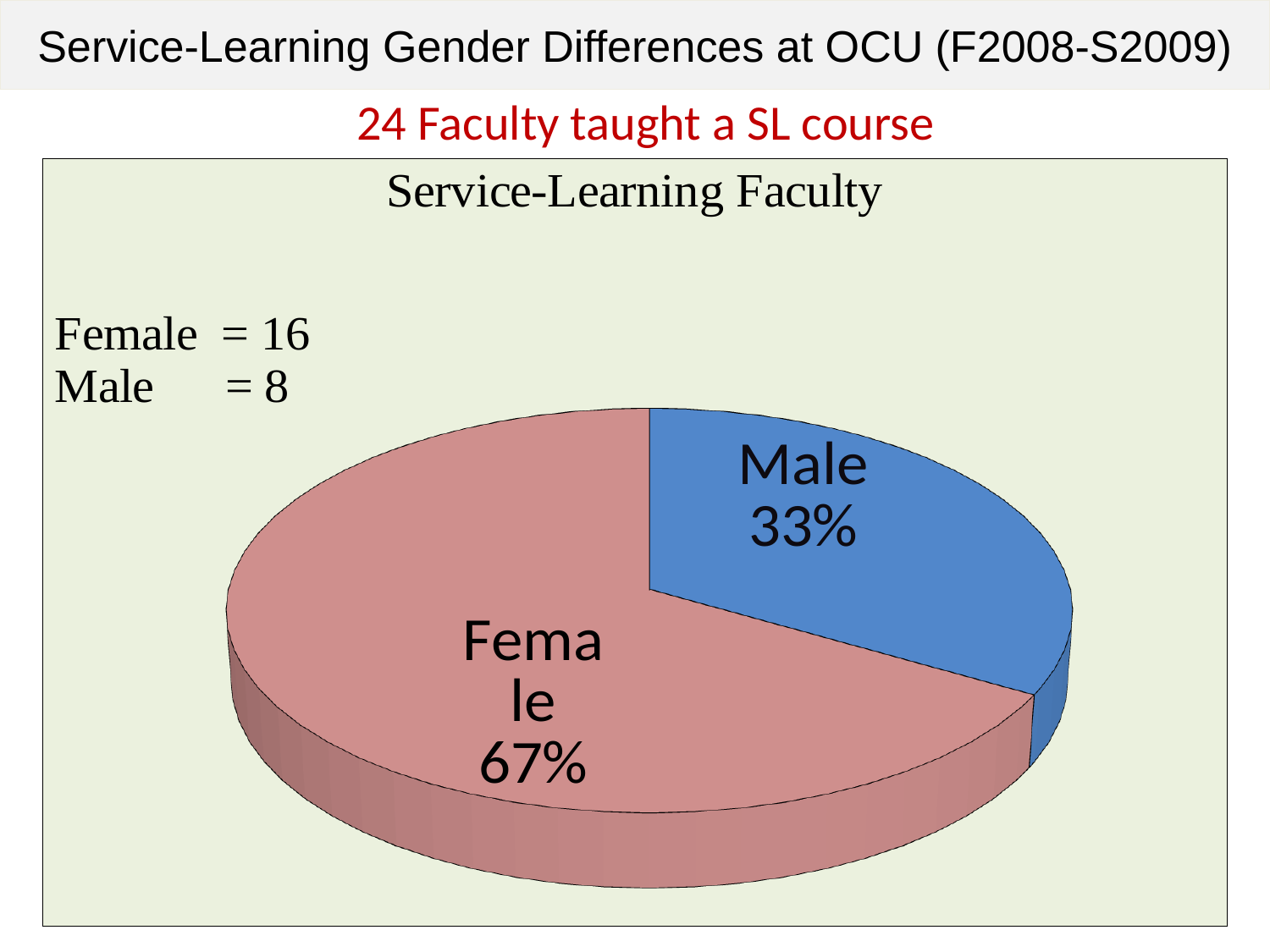
What is the title of the chart? Service-Learning Faculty What percentage of the pie does the Male slice represent? 33% How many slices does the pie chart have? 2 What is the difference in percentage points between the Female and Male slices? 34 What colour is the Male slice of the pie chart? Blue What percentage of the pie does the Female slice represent? 67% What type of chart is shown on the slide? Pie chart Which slice is the smallest in the pie chart? Male Which is larger, the Female slice or the Male slice? Female How many female faculty are listed on the slide? 16 Which slice is the largest in the pie chart? Female How many male faculty are listed on the slide? 8